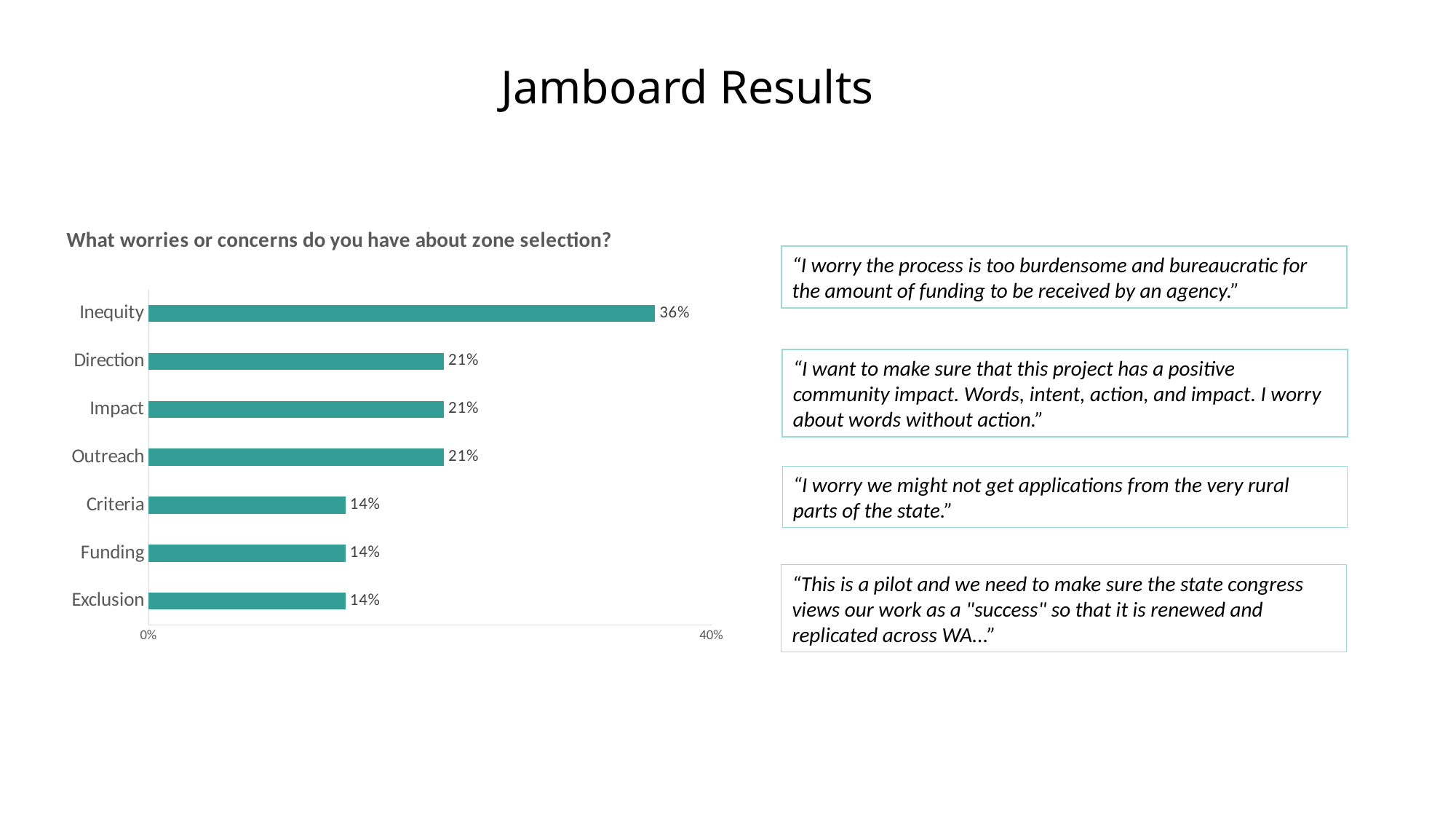
What is the difference between the values for Impact and Funding? 7% What is the difference between the values for Inequity and Direction? 15% How many categories have a value of 21%? 3 Which category has the highest value? Inequity What is the value for Inequity? 36% What kind of chart is shown on the slide? Bar chart What is the maximum value shown on the x axis? 40% Which is larger, the value for Direction or the value for Exclusion? Direction What is the value for Criteria? 14% What is the title of the chart? What worries or concerns do you have about zone selection? How many categories are shown in the chart? 7 What is the value for Outreach? 21%